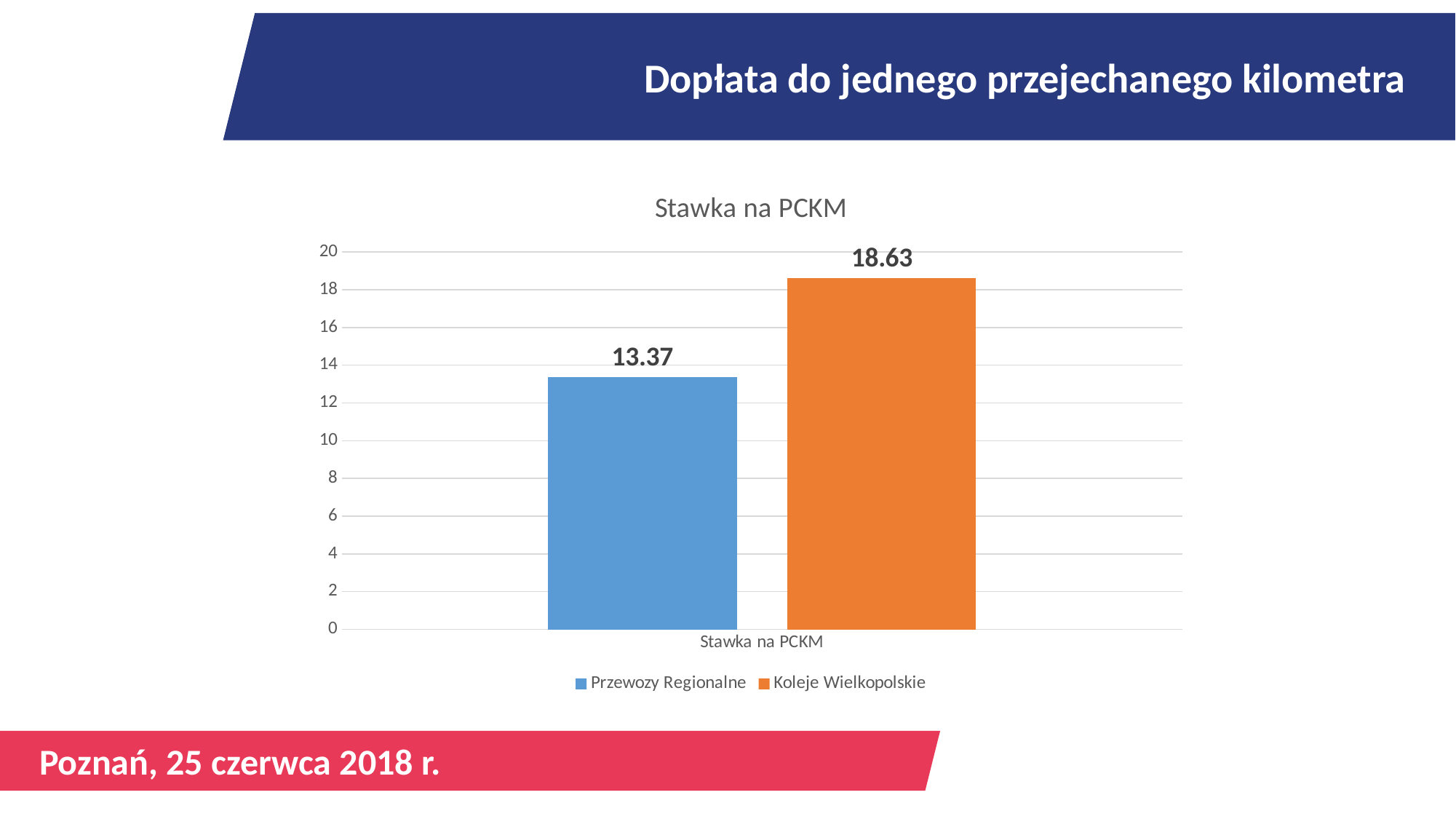
What kind of chart is shown on the slide? bar chart Which series has the lower value? Przewozy Regionalne Is the value for Przewozy Regionalne larger or smaller than the value for Koleje Wielkopolskie? smaller How many series does the legend list? 2 What colour is the bar for Koleje Wielkopolskie? orange What is the title of the chart? Stawka na PCKM Which series has the higher value? Koleje Wielkopolskie Is the value for Przewozy Regionalne greater or less than 14? less What is the value for Przewozy Regionalne? 13.37 What is the difference between the values for Koleje Wielkopolskie and Przewozy Regionalne? 5.26 Is the value for Koleje Wielkopolskie greater or less than 16? greater What is the value for Koleje Wielkopolskie? 18.63